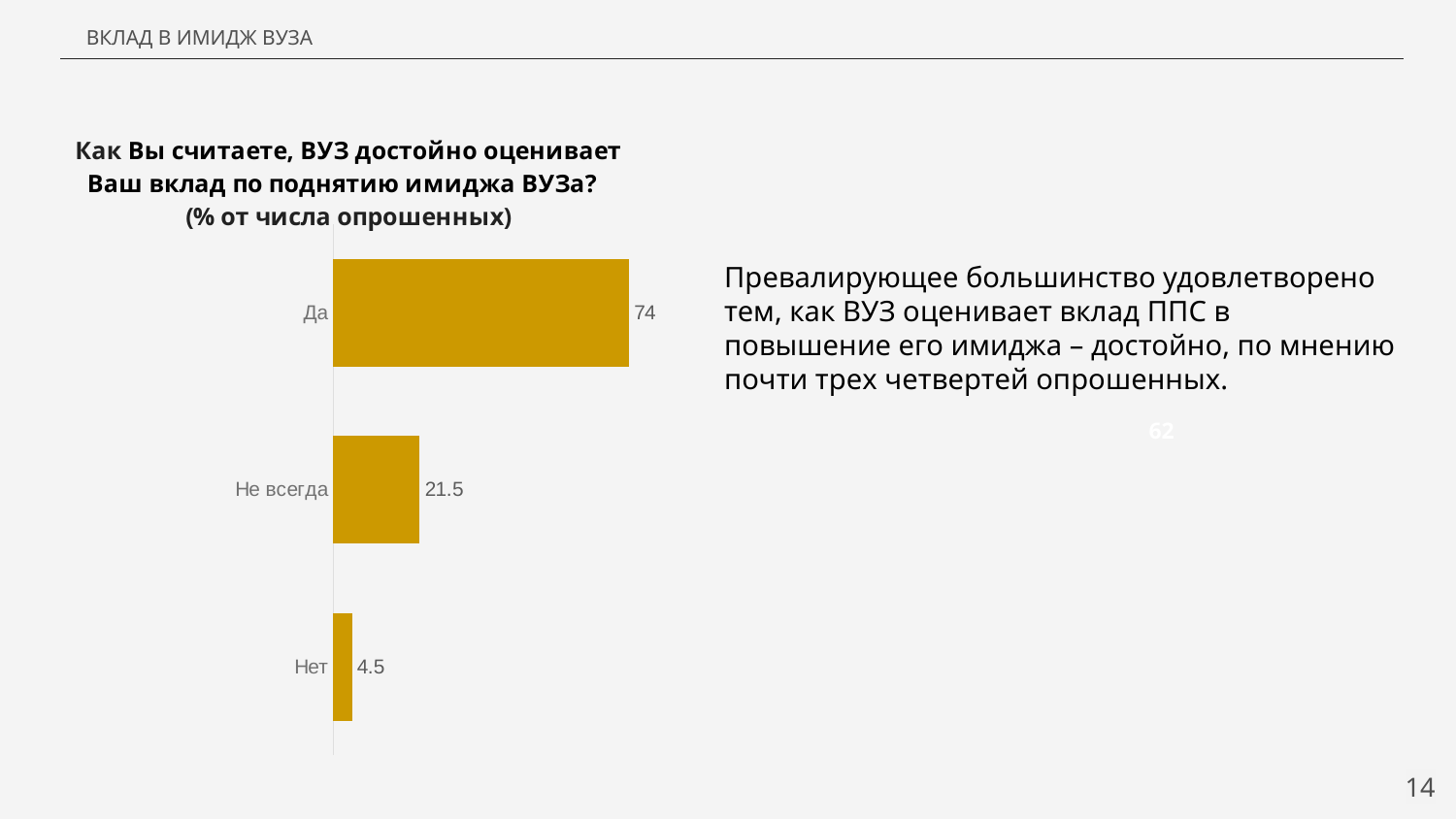
What colour are the bars in the chart? Gold (dark yellow) Which is larger, the value for "Не всегда" or the value for "Нет"? Не всегда What value is shown for the category "Не всегда"? 21.5 What kind of chart is shown on the slide? Bar chart Which category has the highest value? Да What value is shown for the category "Нет"? 4.5 What value is shown for the category "Да"? 74 Which category has the lowest value? Нет What is the title of the chart? Как Вы считаете, ВУЗ достойно оценивает Ваш вклад по поднятию имиджа ВУЗа? (% от числа опрошенных) What is the difference between the values for "Не всегда" and "Нет"? 17 What is the difference between the values for "Да" and "Не всегда"? 52.5 How many categories are shown in the chart? 3